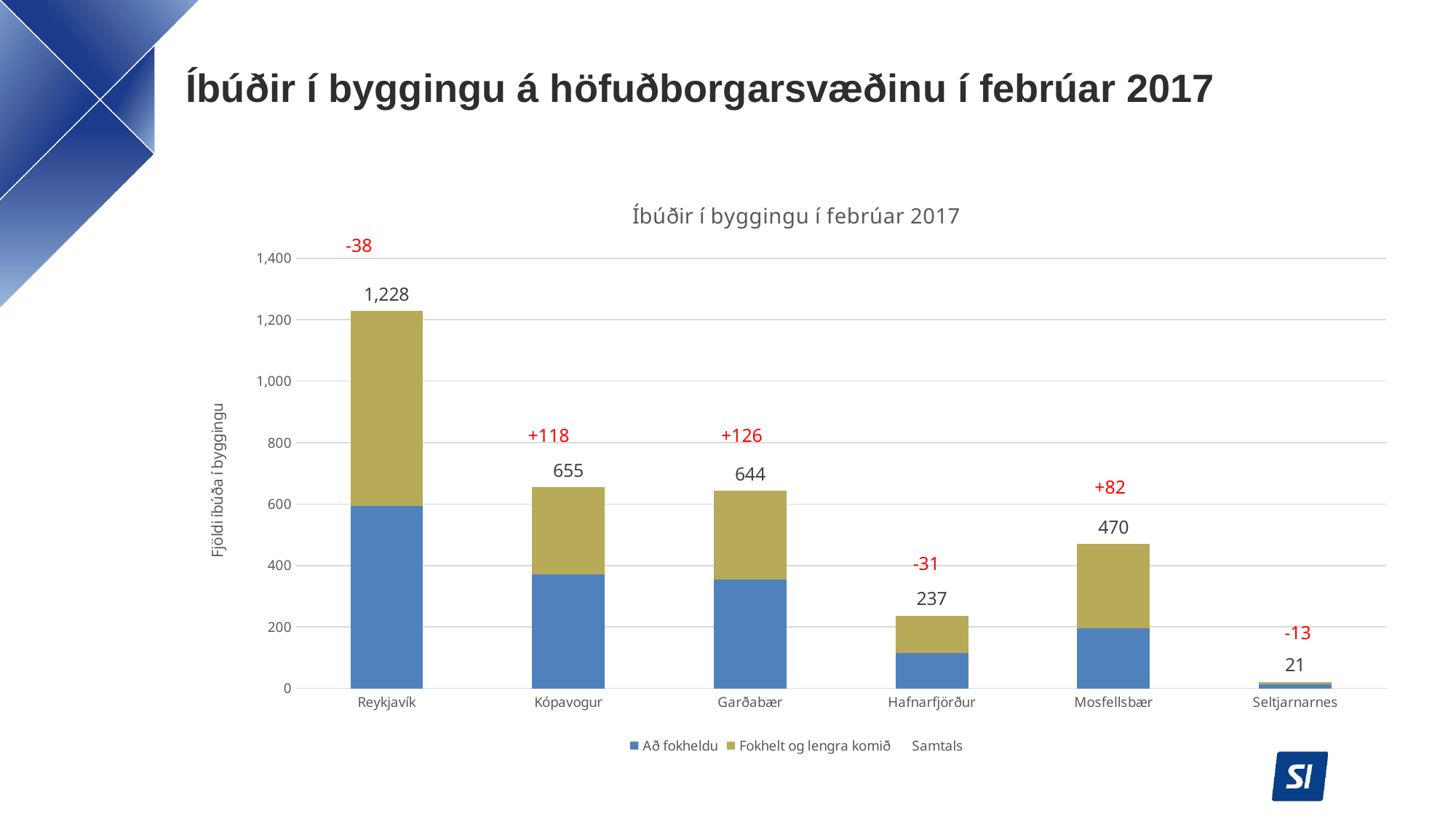
What is the total value shown for Mosfellsbær? 470 What is the difference between the totals for Kópavogur and Garðabær? 11 What type of chart is shown on the slide? Stacked bar chart Which municipality has the lowest total of apartments under construction? Seltjarnarnes What is the total number of apartments under construction (Samtals) in Reykjavík? 1,228 Which has a larger total, Mosfellsbær or Hafnarfjörður? Mosfellsbær Is the 'Að fokheldu' value for Kópavogur greater or less than 400? less Which municipality has the highest total of apartments under construction? Reykjavík What is the total value shown for Hafnarfjörður? 237 How many municipalities are shown on the x axis? 6 How many entries does the legend list? 3 What red change figure is shown above the Garðabær bar? +126